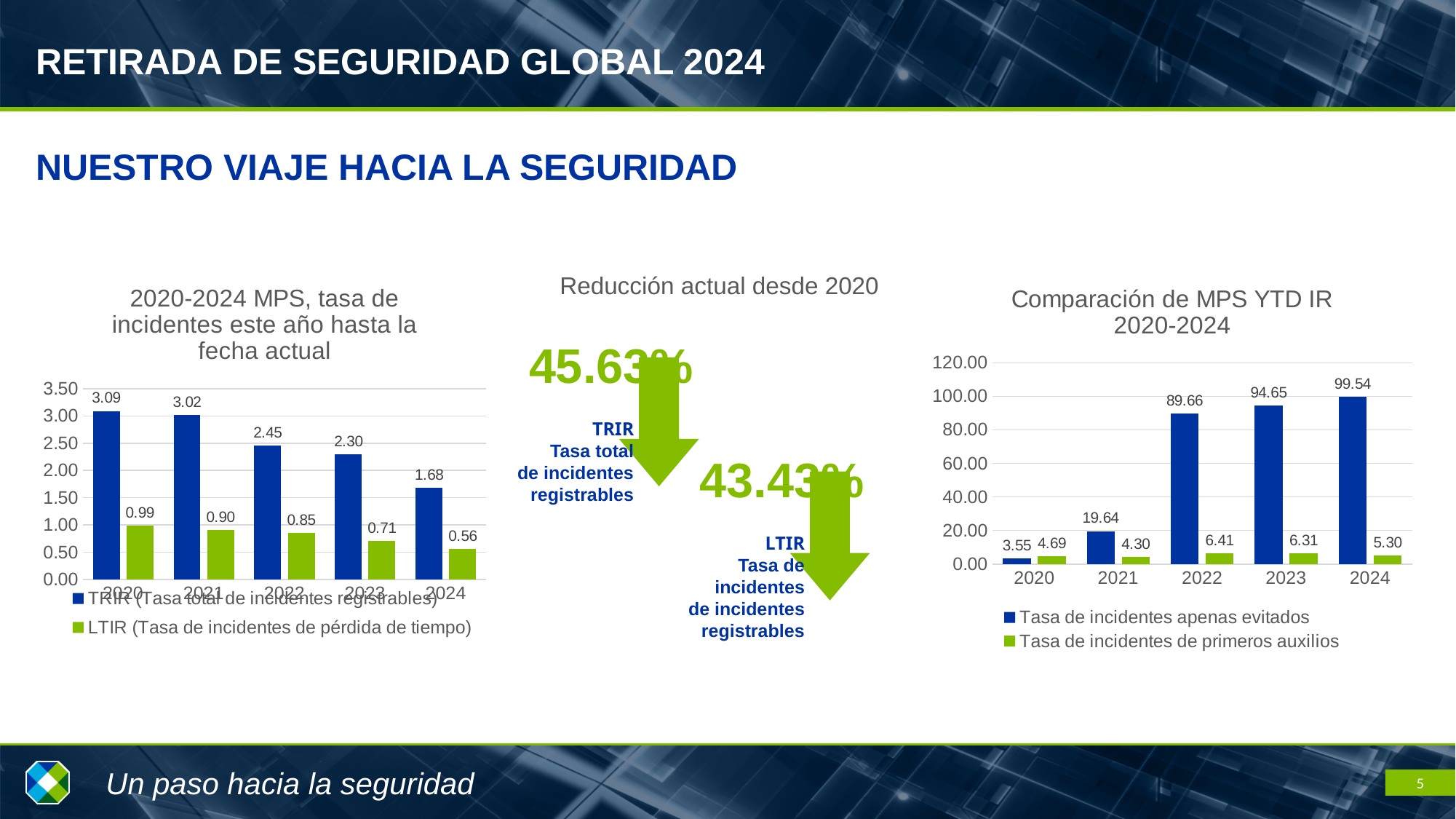
In the left chart (2020-2024 MPS, tasa de incidentes este año hasta la fecha actual), what is the difference between the TRIR values for 2020 and 2024? 1.41 How many series does the legend of the left chart (2020-2024 MPS, tasa de incidentes este año hasta la fecha actual) list? 2 In the left chart (2020-2024 MPS, tasa de incidentes este año hasta la fecha actual), does the TRIR series rise or fall from 2020 to 2024? Fall In the right chart (Comparación de MPS YTD IR 2020-2024), what is the value of Tasa de incidentes de primeros auxilios for 2022? 6.41 What type of chart is the right chart (Comparación de MPS YTD IR 2020-2024)? Bar chart How many years are shown on the x axis of the right chart (Comparación de MPS YTD IR 2020-2024)? 5 In the right chart (Comparación de MPS YTD IR 2020-2024), which is larger in 2020: Tasa de incidentes apenas evitados or Tasa de incidentes de primeros auxilios? Tasa de incidentes de primeros auxilios In the left chart (2020-2024 MPS, tasa de incidentes este año hasta la fecha actual), which year has the highest TRIR value? 2020 In the left chart (2020-2024 MPS, tasa de incidentes este año hasta la fecha actual), what is the LTIR value for 2024? 0.56 In the right chart (Comparación de MPS YTD IR 2020-2024), what is the value of Tasa de incidentes apenas evitados for 2024? 99.54 In the right chart (Comparación de MPS YTD IR 2020-2024), which year has the lowest value for Tasa de incidentes apenas evitados? 2020 In the left chart (2020-2024 MPS, tasa de incidentes este año hasta la fecha actual), what is the TRIR value for 2022? 2.45